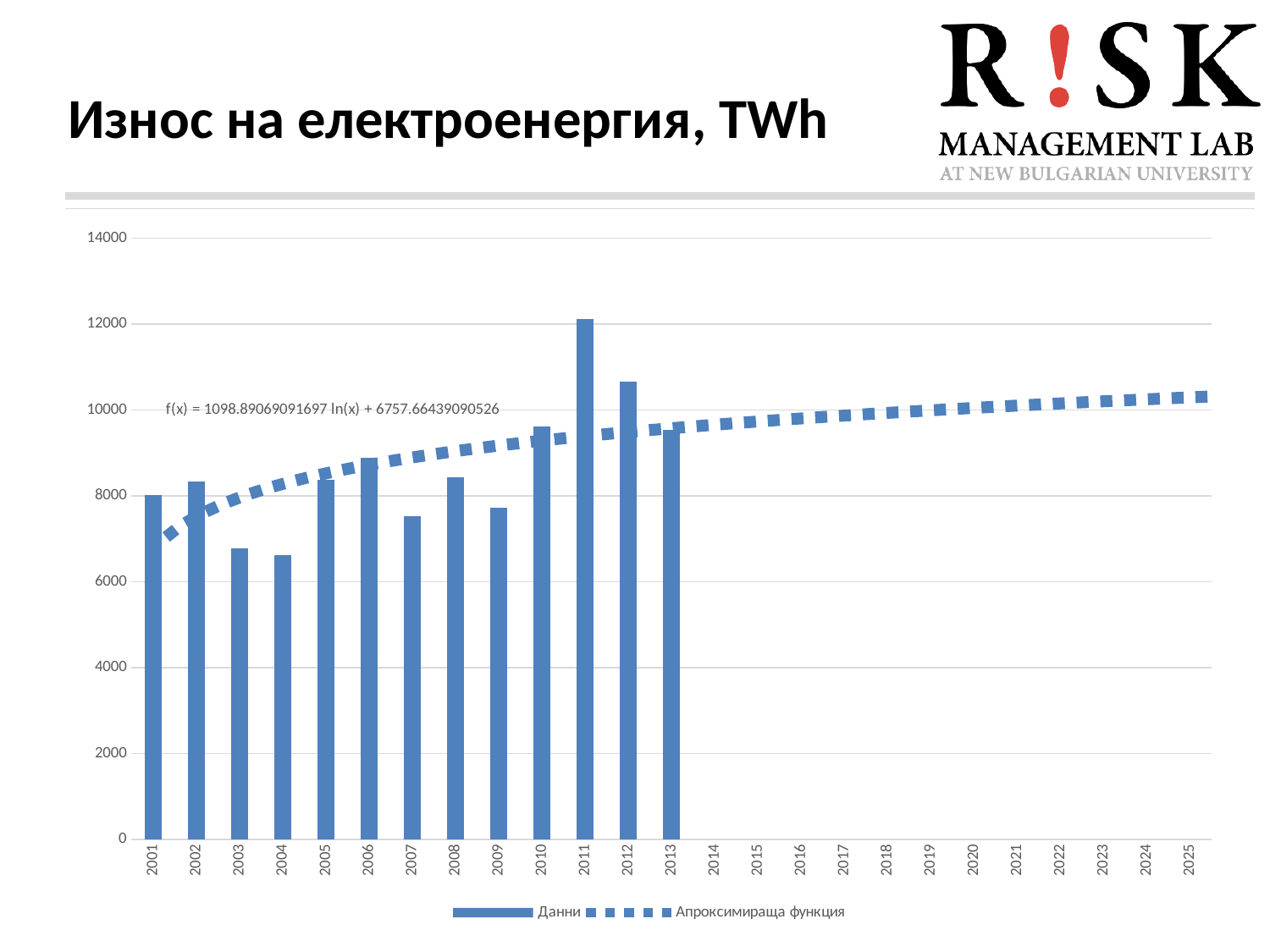
Does the dotted approximating function rise or fall from 2001 to 2025? rise Is the value for 2010 greater or less than 10000? less Is the value for 2007 greater or less than 8000? less Which year has the highest bar? 2011 What kind of chart is shown on the slide? bar chart How many series does the legend list? 2 Which is larger, the value for 2003 or the value for 2005? 2005 Which is larger, the value for 2011 or the value for 2012? 2011 What is the title of the chart? Износ на електроенергия, TWh Is the value for 2011 greater or less than 10000? greater For how many years are bars plotted? 13 What are the two entries in the legend? Данни, Апроксимираща функция